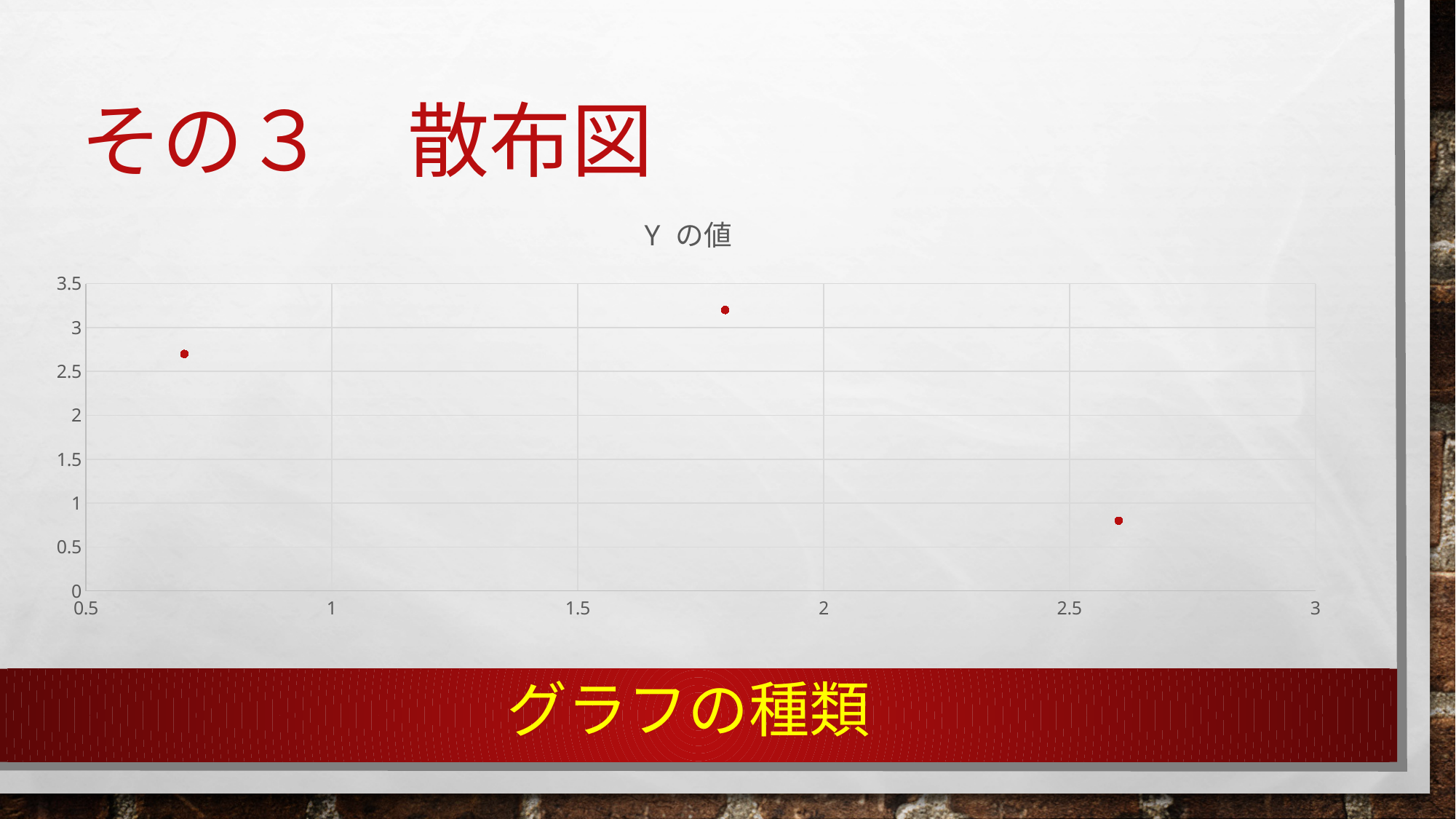
How many data points are plotted on the chart? 3 Is the y value of the middle point greater or less than 3? greater Is the x value of the rightmost point greater or less than 2.5? greater Which point has the highest y value: the leftmost, the middle, or the rightmost point? the middle point What kind of chart is shown on the slide? scatter chart Which has the larger y value, the leftmost point or the rightmost point? the leftmost point Which point has the lowest y value: the leftmost, the middle, or the rightmost point? the rightmost point Is the x value of the leftmost point greater or less than 1? less What is the highest value shown on the y axis? 3.5 What is the title of the chart? Y の値